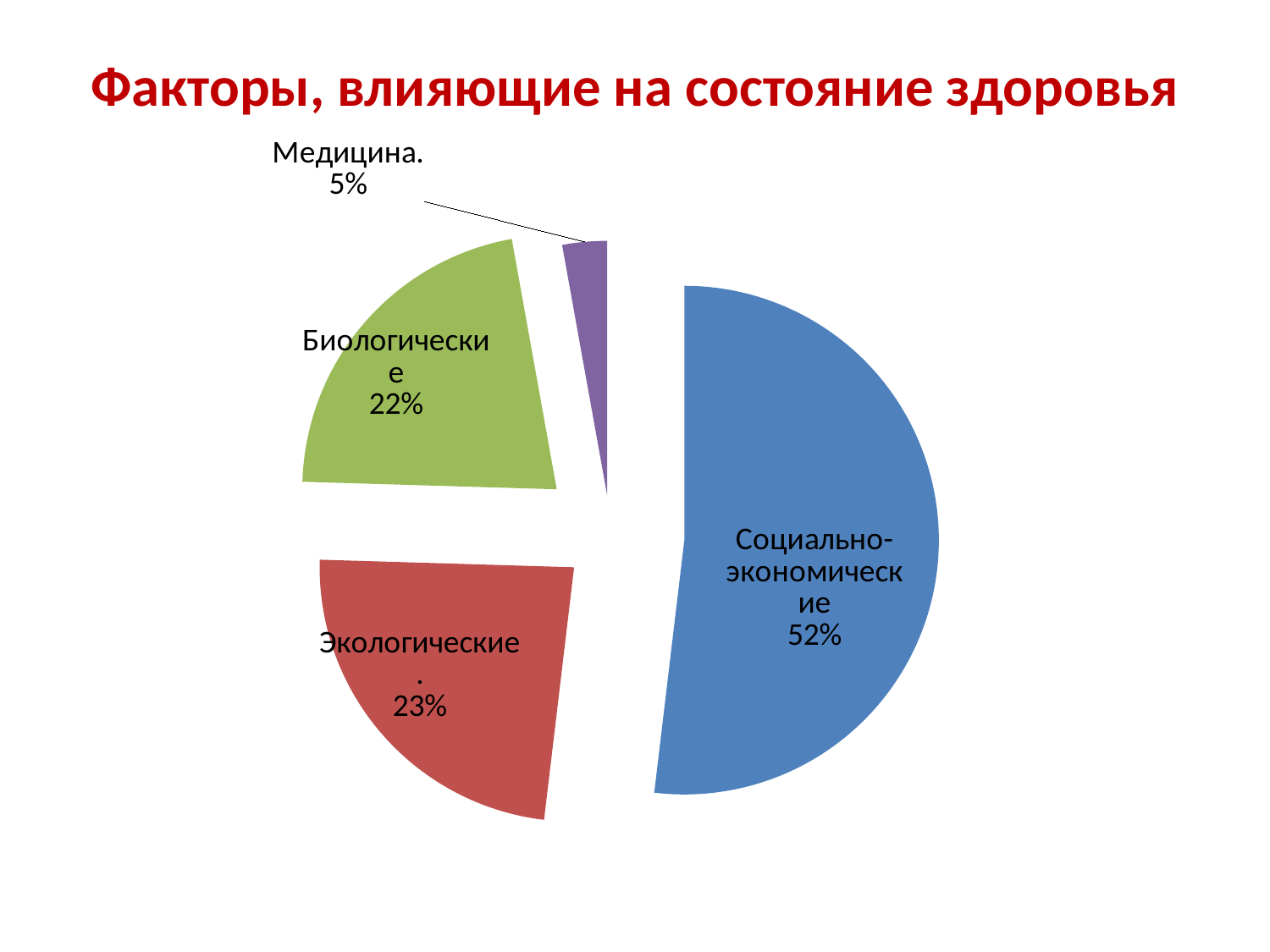
Which slice of the pie is the largest? Социально-экономические What type of chart is shown on the slide? pie chart Which is larger, the share for Экологические or the share for Биологические? Экологические How many slices does the pie chart have? 4 Which slice of the pie is the smallest? Медицина What share of the pie is labelled Медицина? 5% What is the title of the chart? Факторы, влияющие на состояние здоровья What share of the pie is labelled Экологические? 23% What colour is the Социально-экономические slice? blue What share of the pie is labelled Социально-экономические? 52% What share of the pie is labelled Биологические? 22% What is the difference in percentage points between Социально-экономические and Биологические? 30